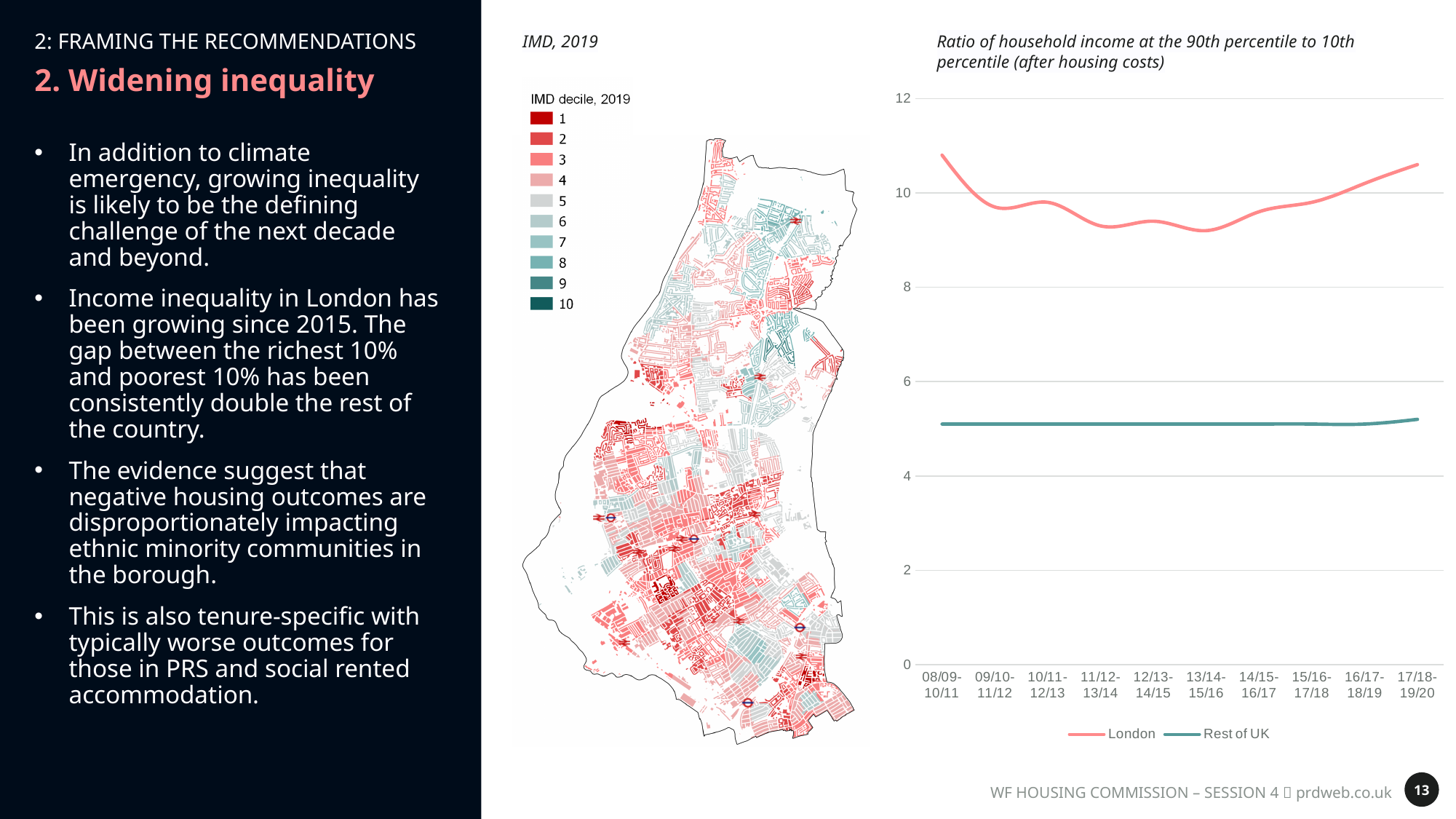
What is the highest value shown on the y axis of the ratio of household income line chart? 12 How many series does the legend of the ratio of household income line chart list? 2 In the ratio of household income line chart, does the London series rise or fall between 08/09-10/11 and 13/14-15/16? fall What are the two legend entries of the ratio of household income line chart? London and Rest of UK In the ratio of household income line chart, is the London value for 08/09-10/11 greater or less than 10? greater In the ratio of household income line chart, is the Rest of UK value for 17/18-19/20 greater or less than 4? greater In the ratio of household income line chart, which series has the higher value in 17/18-19/20, London or Rest of UK? London In the ratio of household income line chart, does the London series rise or fall between 13/14-15/16 and 17/18-19/20? rise How many time periods are shown on the x axis of the ratio of household income line chart? 10 What kind of chart is the 'Ratio of household income at the 90th percentile to 10th percentile (after housing costs)' chart? line chart In the ratio of household income line chart, is the London value for 13/14-15/16 greater or less than 10? less